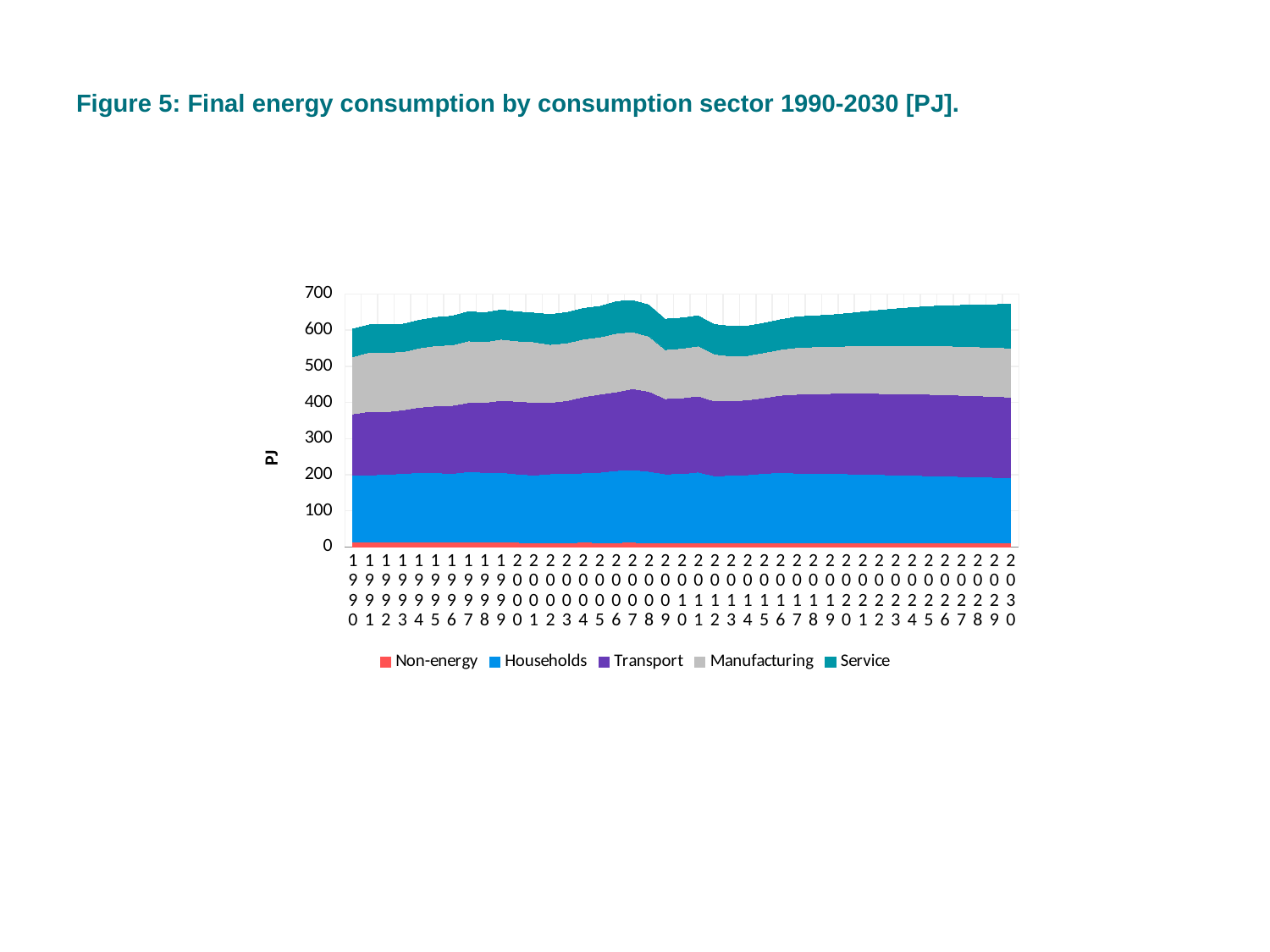
How many series does the legend list? 5 Is the total final energy consumption in 2007 greater or less than 600? greater In 2030, which is larger: the Transport band or the Service band? Transport Is the total final energy consumption in 2030 greater or less than 600? greater Is the total final energy consumption in 2010 greater or less than 700? less What label is shown on the y axis? PJ What is the title of the chart? Figure 5: Final energy consumption by consumption sector 1990-2030 [PJ]. Which series is the smallest band in the stacked area chart? Non-energy Which is larger in 1990: the Households band or the Non-energy band? Households How many years are plotted along the x axis? 41 What kind of chart is shown on the slide? Stacked area chart